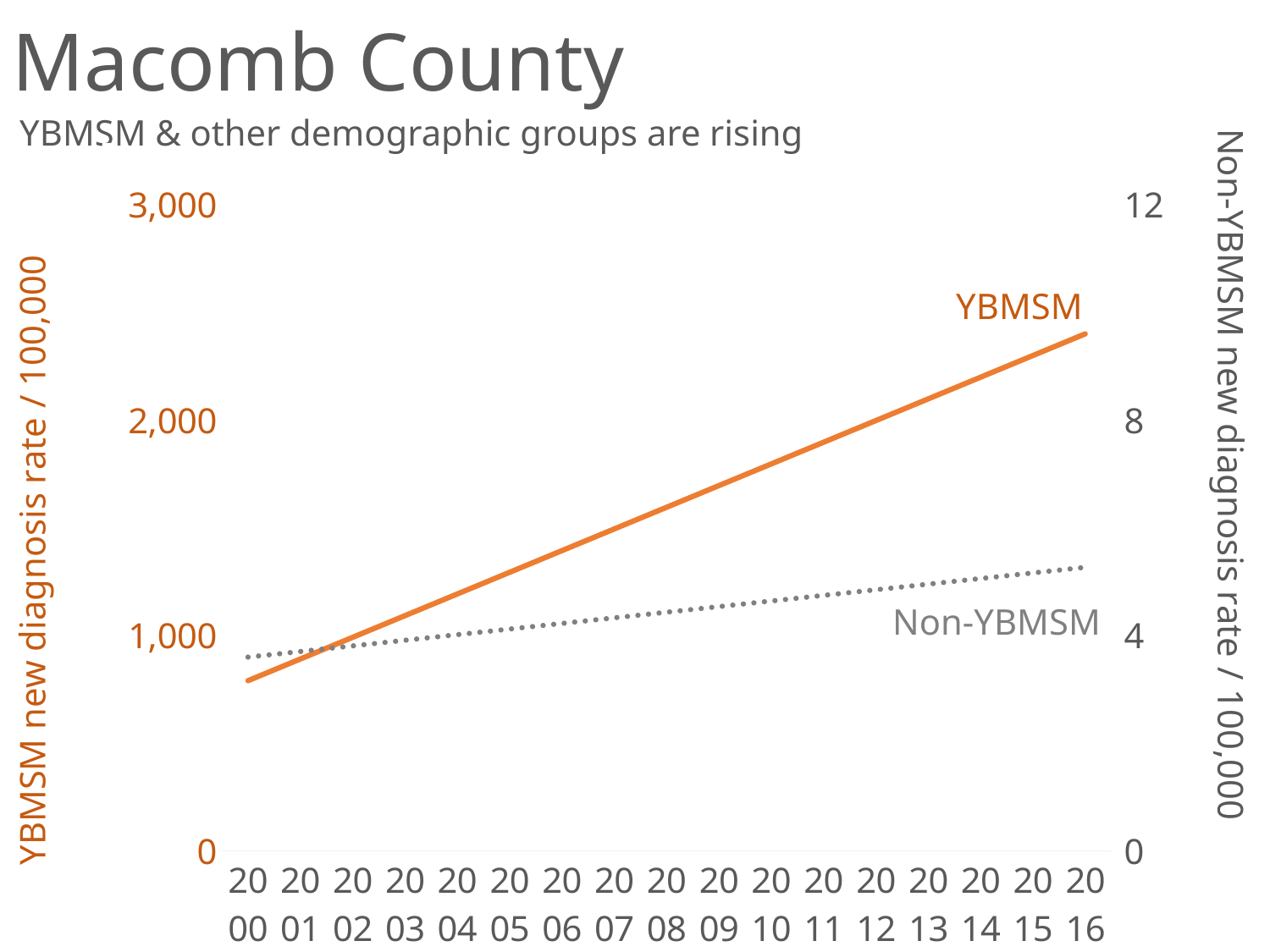
What is the title of the slide? Macomb County Is the Non-YBMSM value for 2016 greater or less than 4? greater How many series are plotted on the chart? 2 In which year is the YBMSM new diagnosis rate highest? 2016 What is the label of the right-hand vertical axis? Non-YBMSM new diagnosis rate / 100,000 How many years are shown along the x axis? 17 What kind of chart is shown on the slide? line chart Is the YBMSM value for 2000 greater or less than 1,000? less In which year is the YBMSM new diagnosis rate lowest? 2000 Does the Non-YBMSM new diagnosis rate rise or fall from 2000 to 2016? rise Is the YBMSM value for 2016 greater or less than 2,000? greater Does the YBMSM new diagnosis rate rise or fall from 2000 to 2016? rise